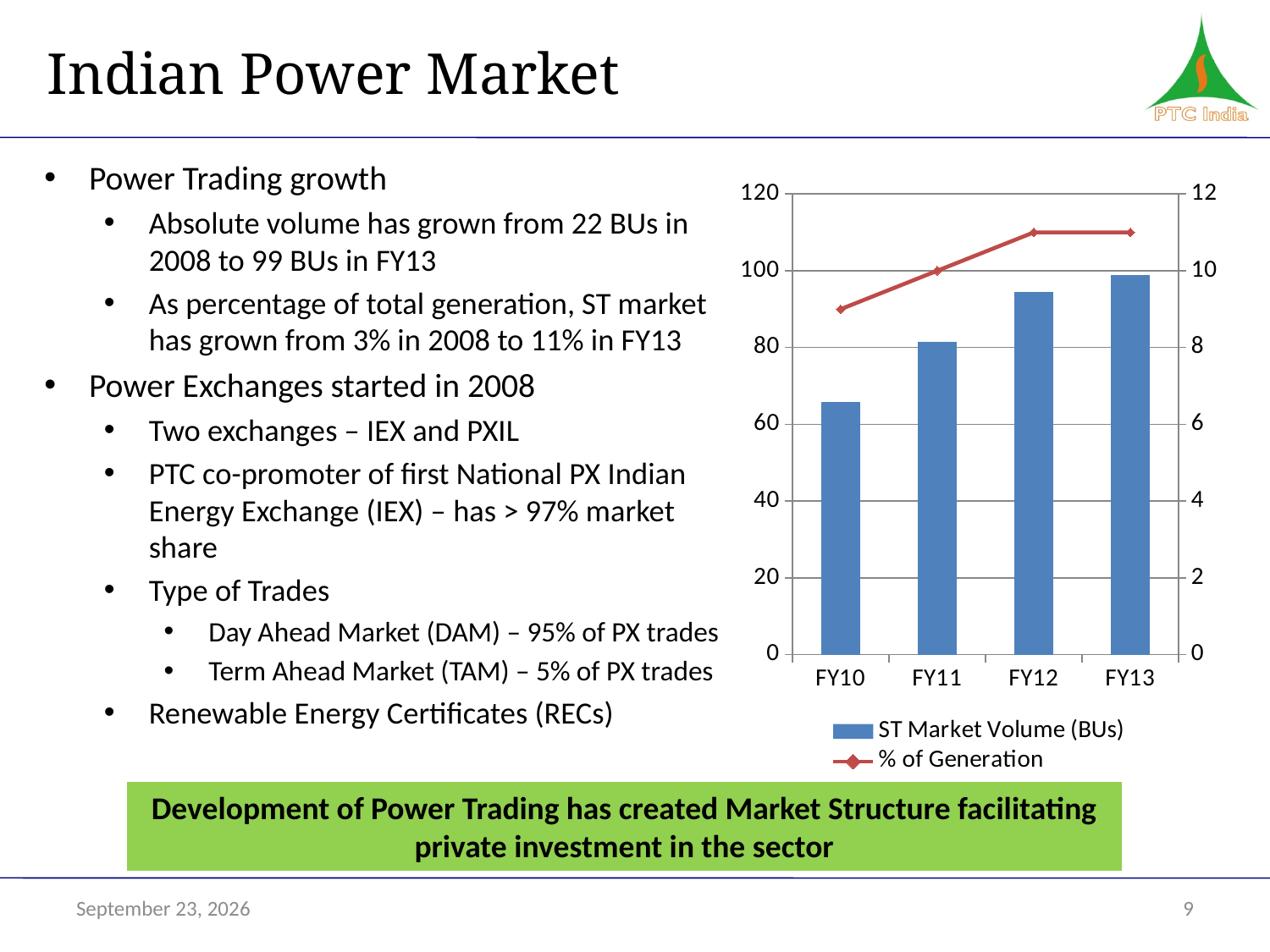
What kind of chart is shown on the slide? A combination bar and line chart Is the ST Market Volume (BUs) bar for FY12 greater or less than 80? greater What is the % of Generation value for FY11 on the chart? 10 Which fiscal year has the highest ST Market Volume (BUs) bar? FY13 Which series in the chart is drawn as a line with markers? % of Generation How many fiscal years are shown on the x axis of the chart? 4 Does the ST Market Volume (BUs) rise or fall from FY10 to FY13? rise How many series does the chart legend list? 2 Which is larger, the ST Market Volume (BUs) for FY11 or for FY12? FY12 Which fiscal year has the lowest ST Market Volume (BUs) bar? FY10 Is the ST Market Volume (BUs) bar for FY10 greater or less than 60? greater